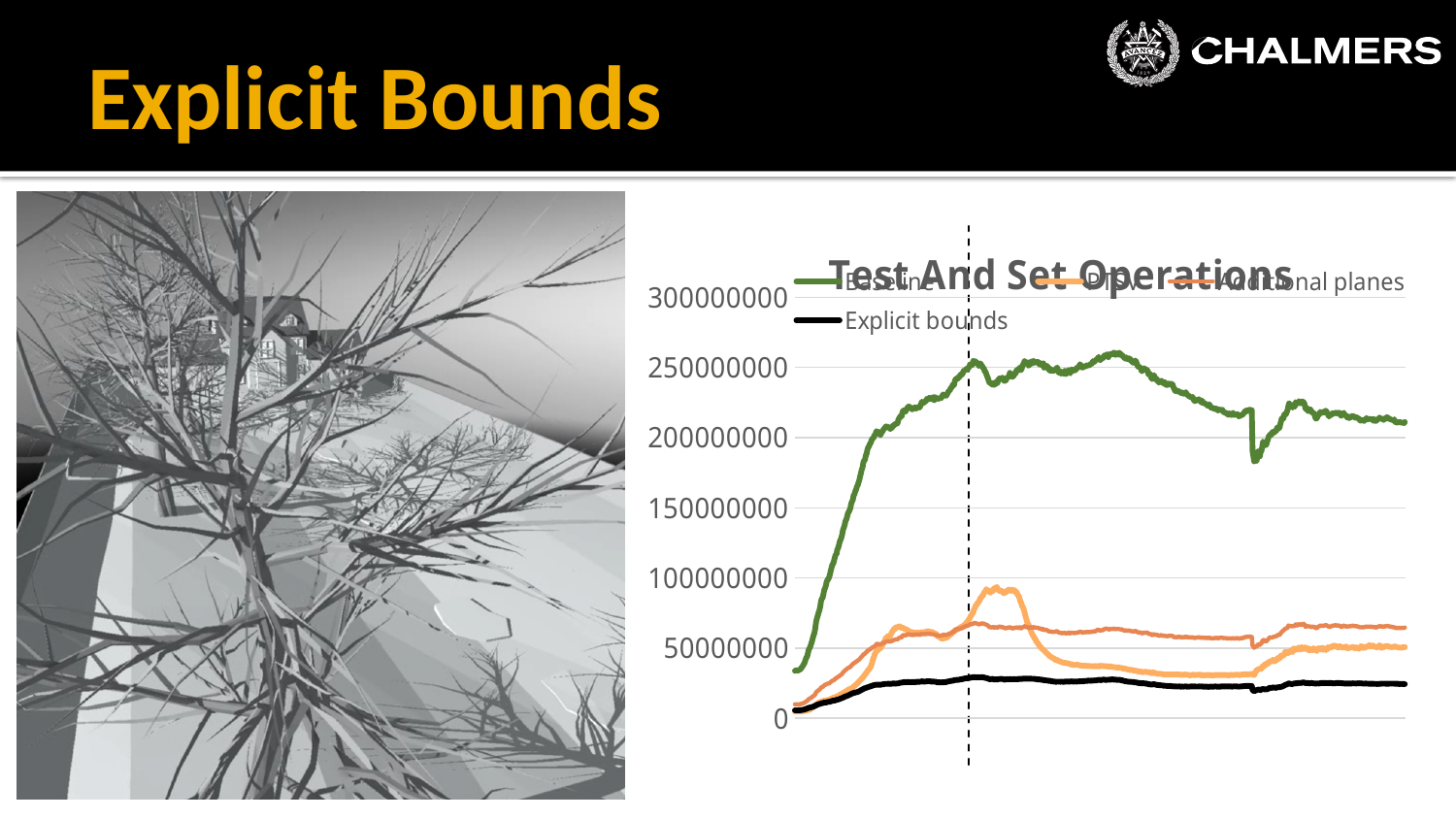
How many series does the chart's legend list? 4 Is the maximum value of the Baseline series greater or less than 300000000? less What kind of chart is shown on the slide? line chart Which series has larger values, Baseline or Explicit bounds? Baseline What is the highest value shown on the y axis? 300000000 Does the Baseline series rise or fall at the start of the x axis? rise Which series has the highest values throughout the chart? Baseline What is the title of the chart? Test And Set Operations What colour is the Explicit bounds line? black Is the maximum value of the Baseline series greater or less than 200000000? greater Is the maximum value of the Explicit bounds series greater or less than 50000000? less